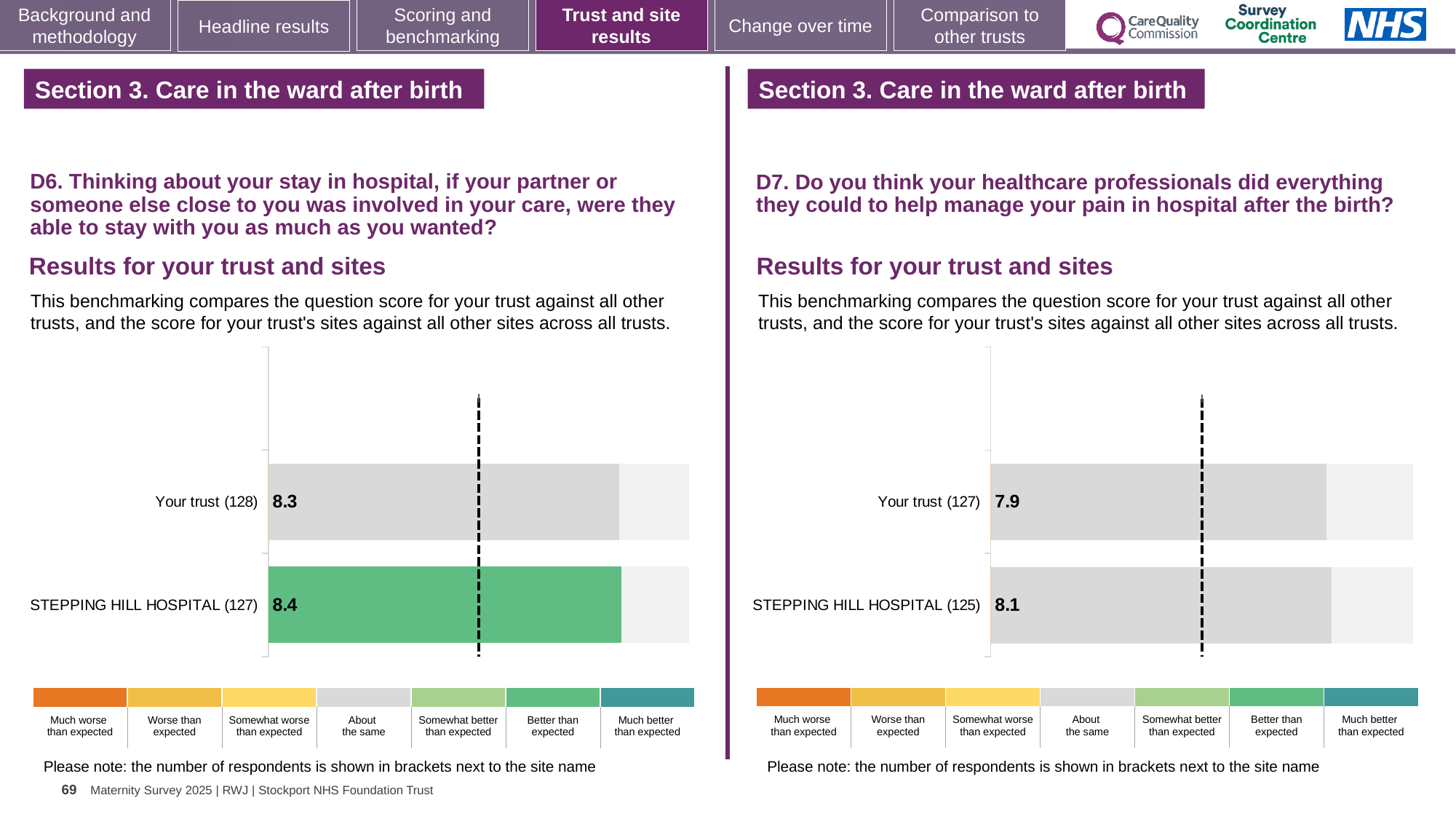
In the D6 chart on the left, how many respondents are shown in brackets for STEPPING HILL HOSPITAL? 127 In the D7 chart on the right, what is the difference between the STEPPING HILL HOSPITAL score and the Your trust score? 0.2 In the D6 chart on the left, what is the score for Your trust? 8.3 What kind of chart is used in the D7 chart on the right? Bar chart In the D7 chart on the right, what is the score for STEPPING HILL HOSPITAL? 8.1 In the D7 chart on the right, which has the higher score, Your trust or STEPPING HILL HOSPITAL? STEPPING HILL HOSPITAL In the D6 chart on the left, what is the score for STEPPING HILL HOSPITAL? 8.4 In the D6 chart on the left, what is the difference between the STEPPING HILL HOSPITAL score and the Your trust score? 0.1 In the D6 chart on the left, which benchmark category does the green colour of the STEPPING HILL HOSPITAL bar represent according to the key? Better than expected In the D7 chart on the right, how many respondents are shown in brackets for STEPPING HILL HOSPITAL? 125 In the D7 chart on the right, what is the score for Your trust? 7.9 How many bars are plotted in the D6 chart on the left? 2